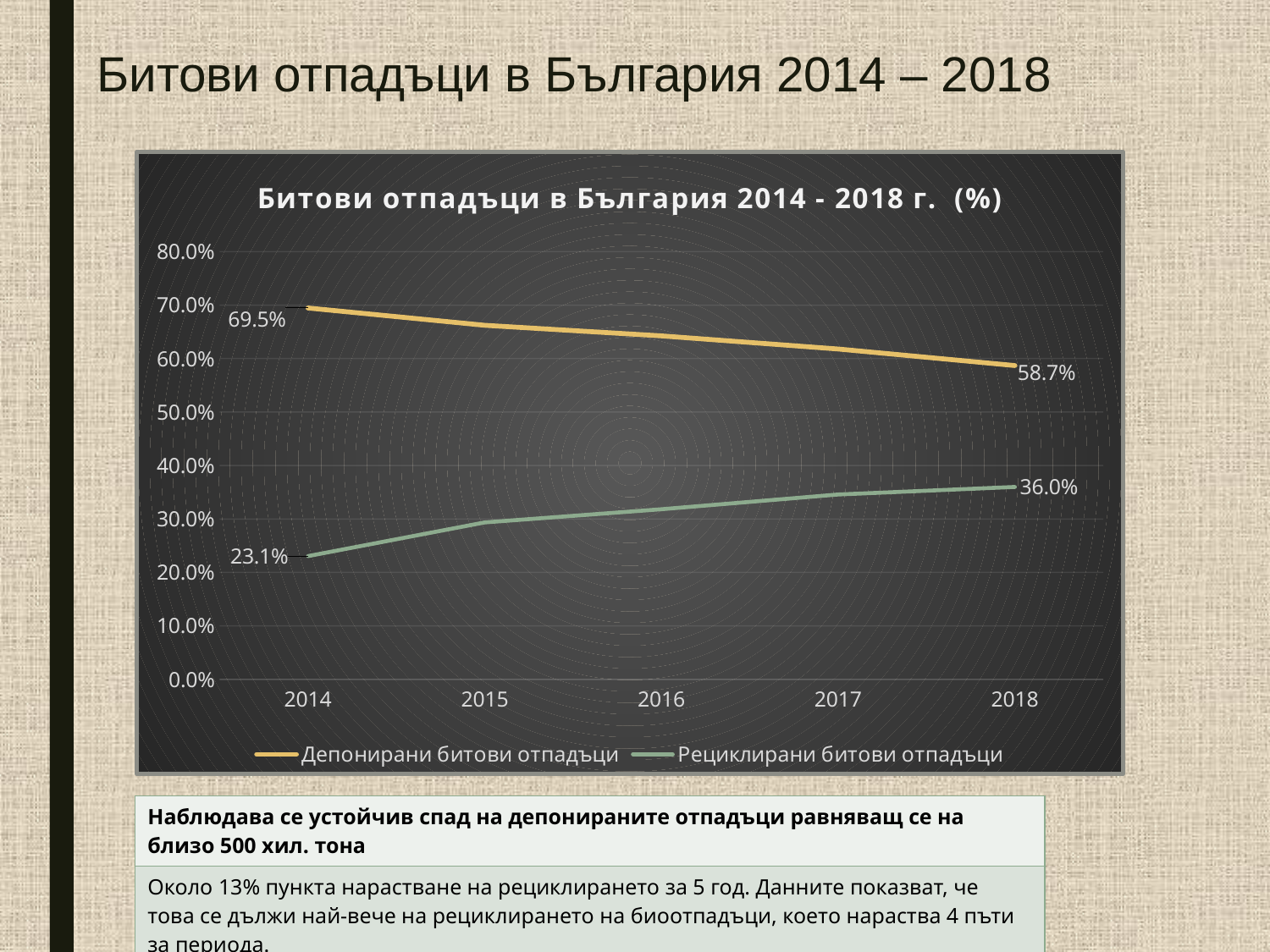
In 2018, which series has the higher value: Депонирани битови отпадъци or Рециклирани битови отпадъци? Депонирани битови отпадъци What is the value for Депонирани битови отпадъци in 2018? 58.7% What is the value for Рециклирани битови отпадъци in 2014? 23.1% What kind of chart is shown on the slide? Line chart What is the value for Депонирани битови отпадъци in 2014? 69.5% What is the value for Рециклирани битови отпадъци in 2018? 36.0% How many years are shown on the x axis of the chart? 5 Is the value for Рециклирани битови отпадъци in 2017 greater or less than 30.0%? greater By how many percentage points did Рециклирани битови отпадъци rise from 2014 to 2018? 12.9 percentage points By how many percentage points did Депонирани битови отпадъци fall from 2014 to 2018? 10.8 percentage points How many series does the chart's legend list? 2 Is the value for Депонирани битови отпадъци in 2016 greater or less than 60.0%? greater